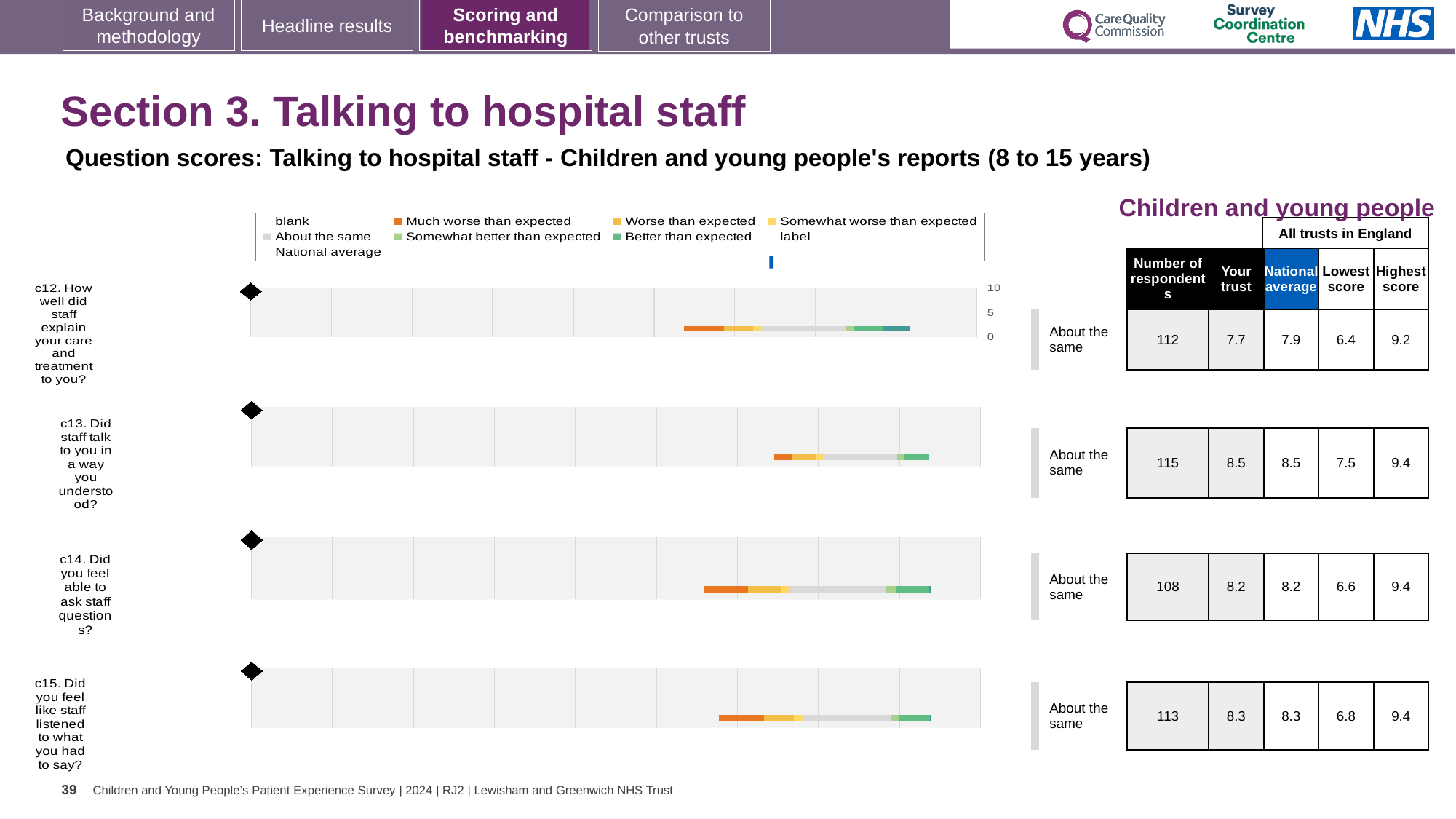
Which question has the highest 'Your trust' score? c13 What kind of chart is used for the question scores on this slide? bar chart What is the national average score for c13 (Did staff talk to you in a way you understood?)? 8.5 For c12, which is larger: the 'Your trust' score or the national average? National average What is the highest score across all trusts in England for c12? 9.2 How many questions (c12 to c15) are plotted on the slide? 4 What benchmark category is shown next to each of the four questions? About the same What is the 'Your trust' score for c12 (How well did staff explain your care and treatment to you?)? 7.7 What is the difference between the national average and the 'Your trust' score for c12? 0.2 How many respondents answered c14 (Did you feel able to ask staff questions?)? 108 Which question has the lowest 'Your trust' score? c12 What is the lowest score across all trusts in England for c15 (Did you feel like staff listened to what you had to say?)? 6.8